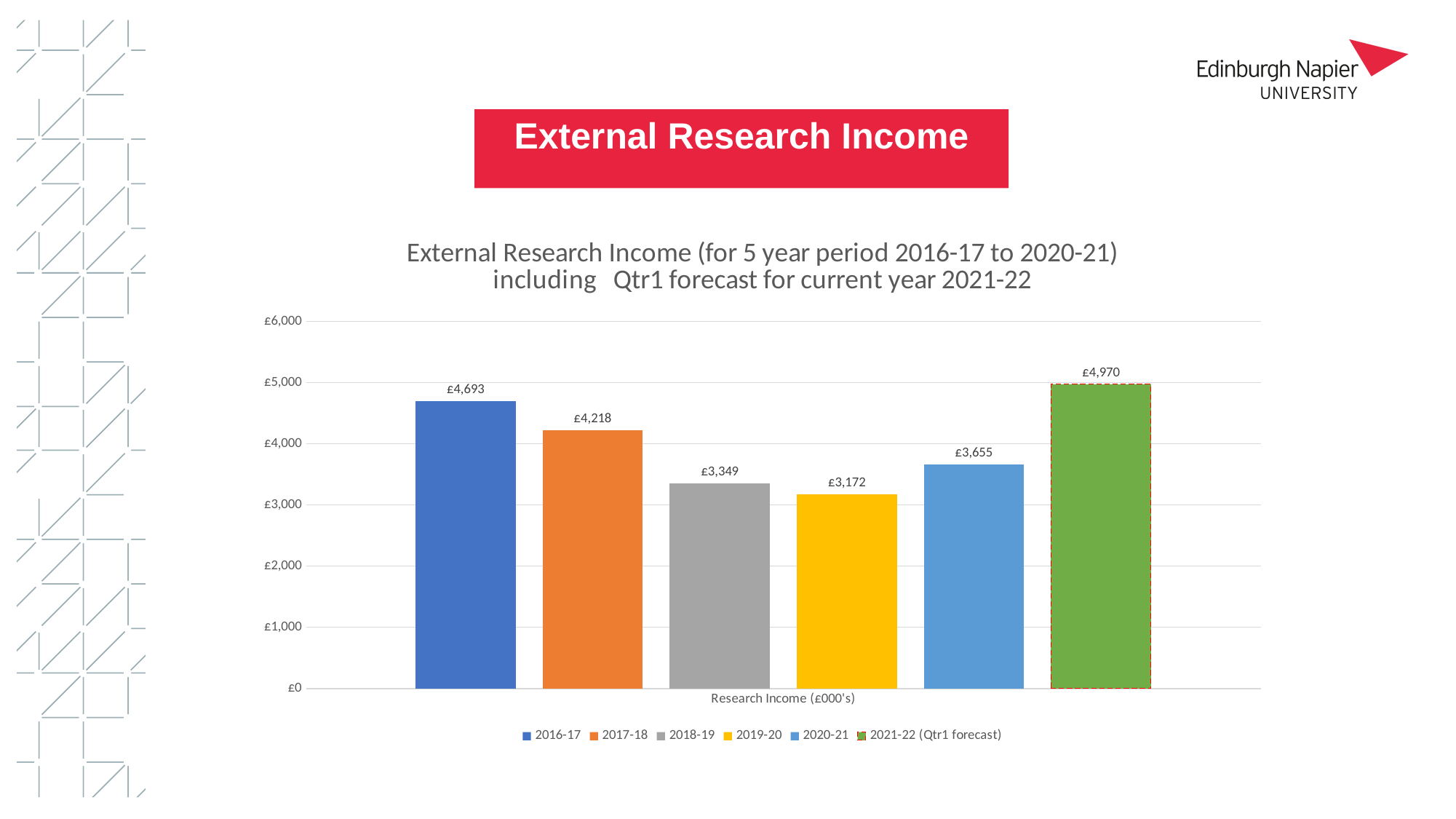
Which year has the highest external research income shown? 2021-22 (Qtr1 forecast) What is the difference between the 2020-21 value and the 2019-20 value? £483 How many series does the legend list? 6 What is the external research income for 2016-17? £4,693 What is the external research income for 2019-20? £3,172 Is the value for 2017-18 greater or less than £4,000? greater What colour is the bar for 2021-22 (Qtr1 forecast)? Green Which year has the lowest external research income shown? 2019-20 Which is larger, the value for 2018-19 or the value for 2020-21? 2020-21 What is the Qtr1 forecast value for 2021-22? £4,970 What is the difference between the 2016-17 value and the 2017-18 value? £475 What kind of chart is shown on the slide? Bar chart